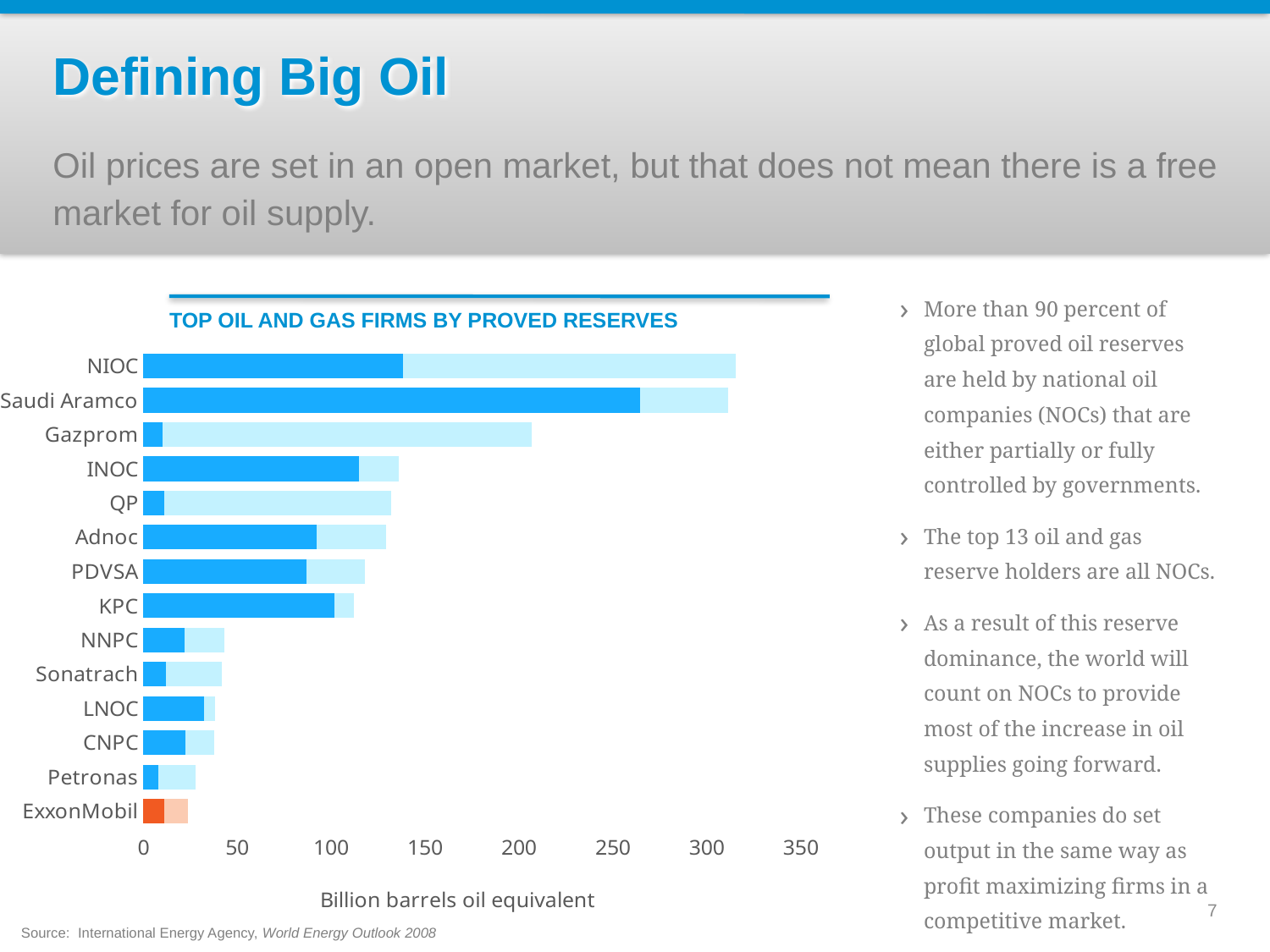
What is the title of the chart? TOP OIL AND GAS FIRMS BY PROVED RESERVES Which has the longer total bar, Saudi Aramco or Gazprom? Saudi Aramco Is the total bar length for Saudi Aramco greater or less than 300? greater Is the total bar length for NNPC greater or less than 50? less Is the total bar length for KPC greater or less than 100? greater Which has the longer total bar, Gazprom or INOC? Gazprom How many companies are listed on the chart? 14 Which has the longer total bar, Adnoc or NNPC? Adnoc What unit is shown on the horizontal axis of the chart? Billion barrels oil equivalent What kind of chart is shown on the slide? Bar chart